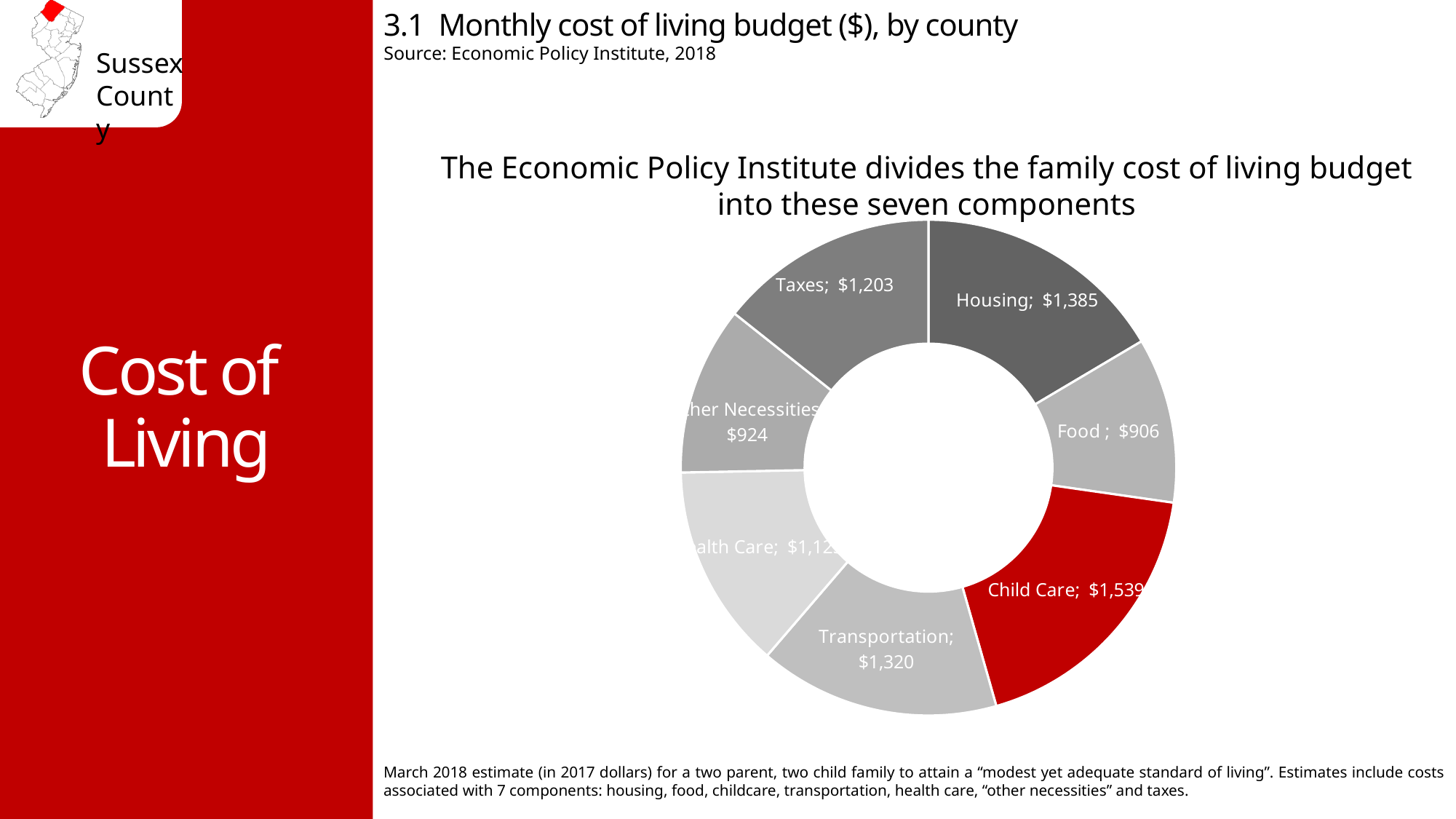
What is the monthly cost for Food shown on the chart? $906 What is the monthly cost for Taxes shown on the chart? $1,203 What is the monthly cost for Housing shown on the chart? $1,385 Which is larger, the monthly cost for Taxes or for Transportation? Transportation What is the monthly cost for Transportation shown on the chart? $1,320 How much more is the monthly cost of Housing than Food? $479 Which component has the highest monthly cost? Child Care What is the monthly cost for Child Care shown on the chart? $1,539 How many components are shown in the chart? 7 What kind of chart is used on this slide? Pie (donut) chart How much more is the monthly cost of Child Care than Housing? $154 Which component has the lowest monthly cost? Food